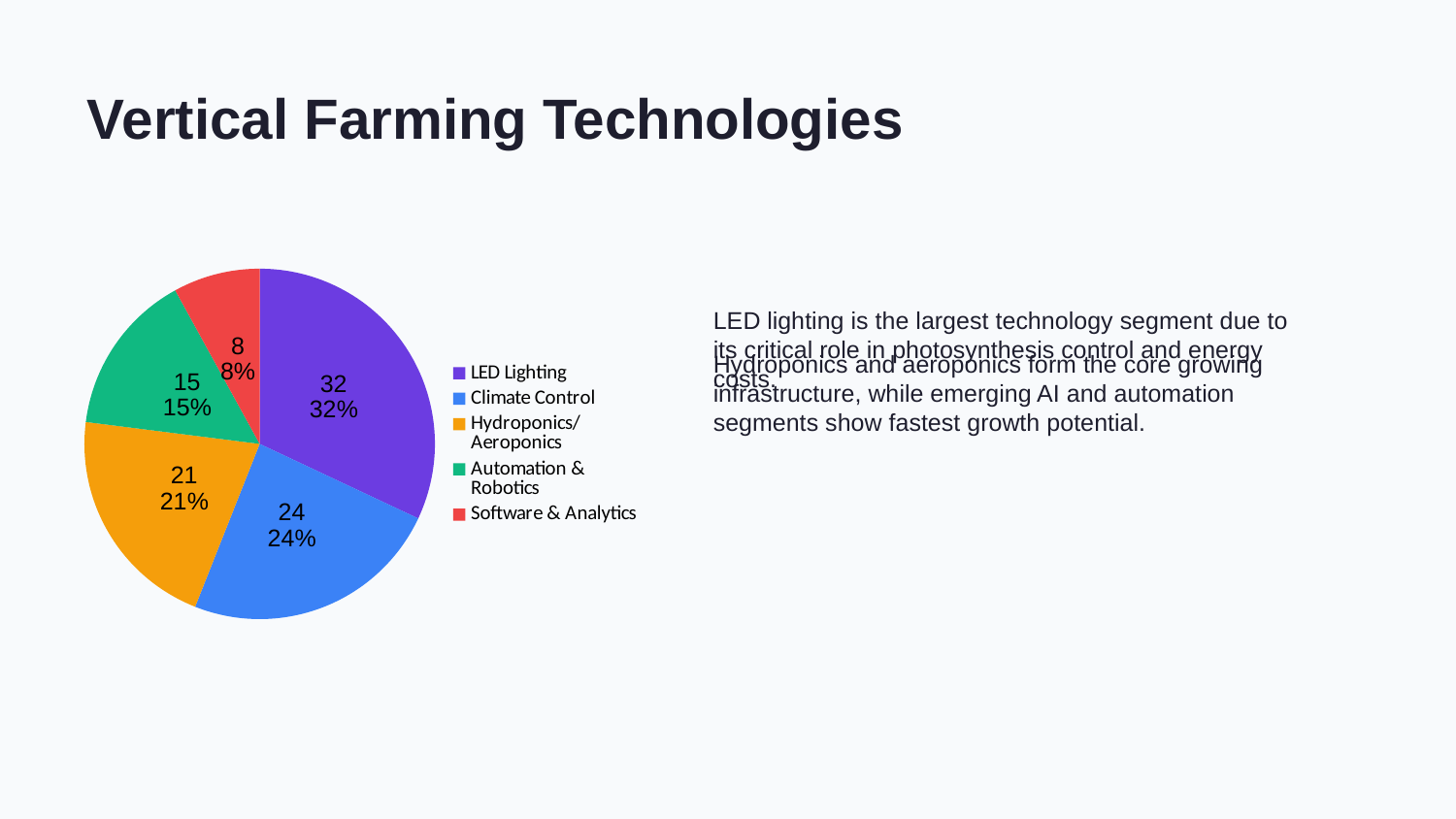
Which category has the smallest slice? Software & Analytics What is the value for Climate Control? 24 What is the value for Hydroponics/Aeroponics? 21 What colour is the Hydroponics/Aeroponics slice? orange What is the value for LED Lighting? 32 What is the value for Software & Analytics? 8 What is the difference between the values for LED Lighting and Automation & Robotics? 17 Which category has the largest slice? LED Lighting What kind of chart is shown on the slide? pie chart What share of the pie does Automation & Robotics represent? 15% How many categories are shown in the pie chart? 5 Which is larger, Climate Control or Hydroponics/Aeroponics? Climate Control